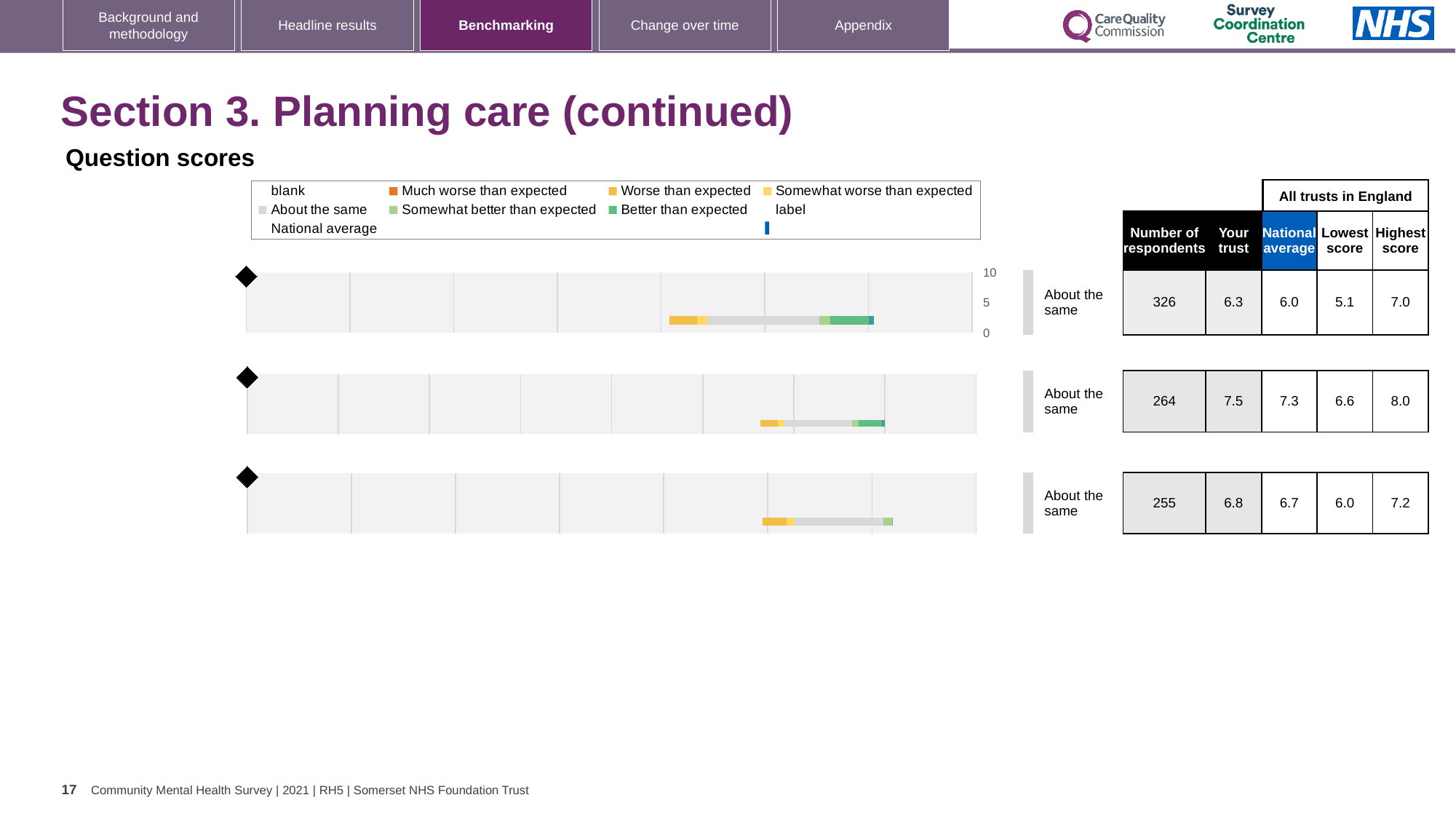
For the middle chart row, what is the highest score among all trusts in England? 8.0 Which chart row (top, middle or bottom) has the highest 'Your trust' score? middle For the top chart row, which is larger: the 'Your trust' score or the national average? Your trust For the top chart row, what is the 'Your trust' score? 6.3 What benchmark category label is shown next to each of the three charts? About the same How many benchmarking charts are shown on the slide? 3 What is the maximum value shown on the score axis of the top chart? 10 For the middle chart row, what is the national average score? 7.3 Which chart row (top, middle or bottom) has the lowest number of respondents? bottom For the bottom chart row, how many respondents are listed? 255 What type of chart is used for the three benchmarking rows on the slide? bar chart For the bottom chart row, what is the difference between the highest score and the lowest score? 1.2